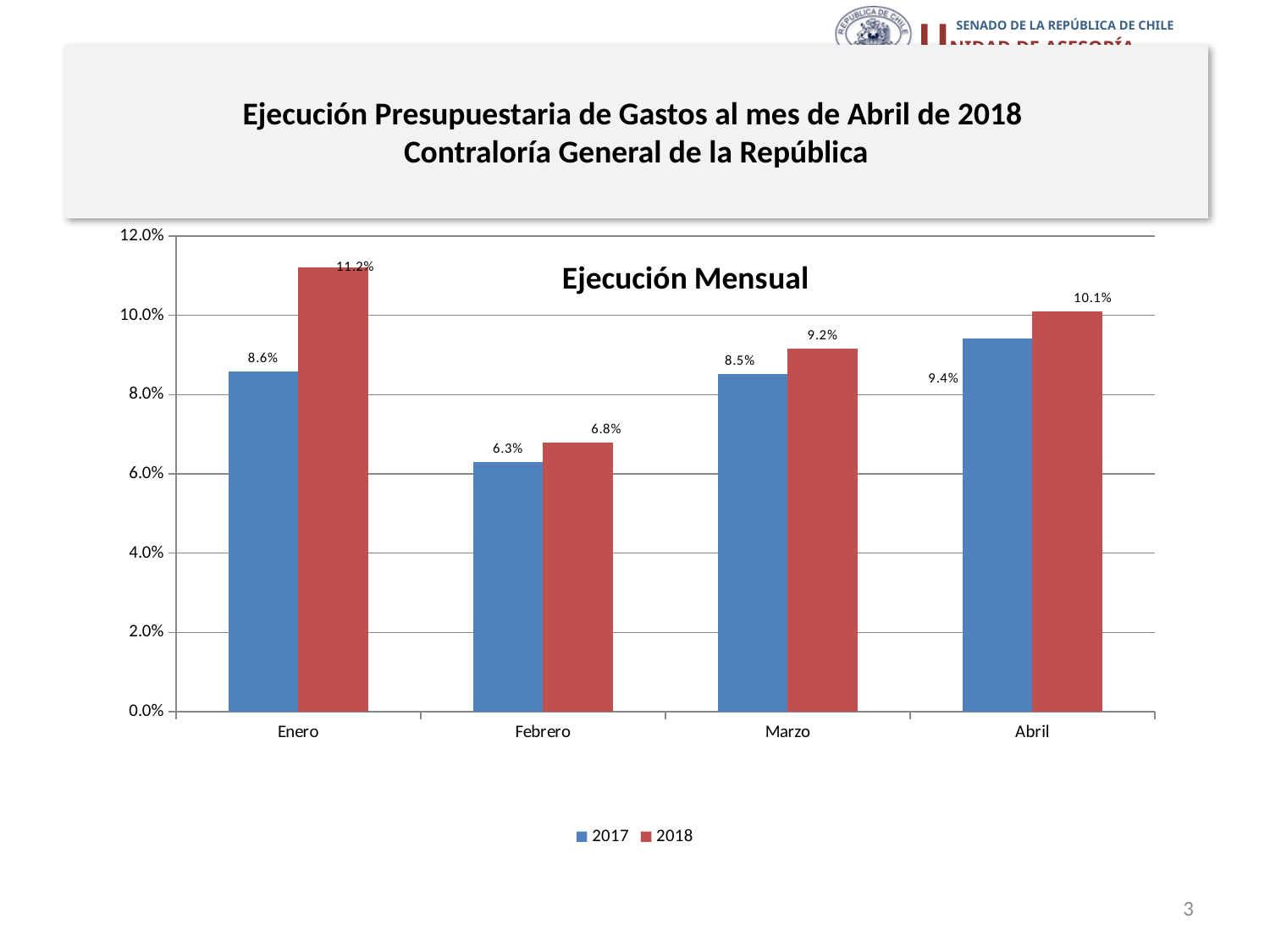
Which month has the highest value for the 2018 series? Enero How many series does the legend list? 2 Which month has the lowest value for the 2017 series? Febrero What kind of chart is shown? bar chart What is the value for 2018 in Abril? 10.1% Is the value for 2017 in Abril greater or less than 10.0%? less What is the value for 2017 in Febrero? 6.3% How many months are shown on the x axis? 4 What is the value for 2018 in Enero? 11.2% What is the difference between the 2018 and 2017 values in Enero? 2.6% Which is larger in Marzo, the 2017 value or the 2018 value? 2018 What is the value for 2017 in Marzo? 8.5%